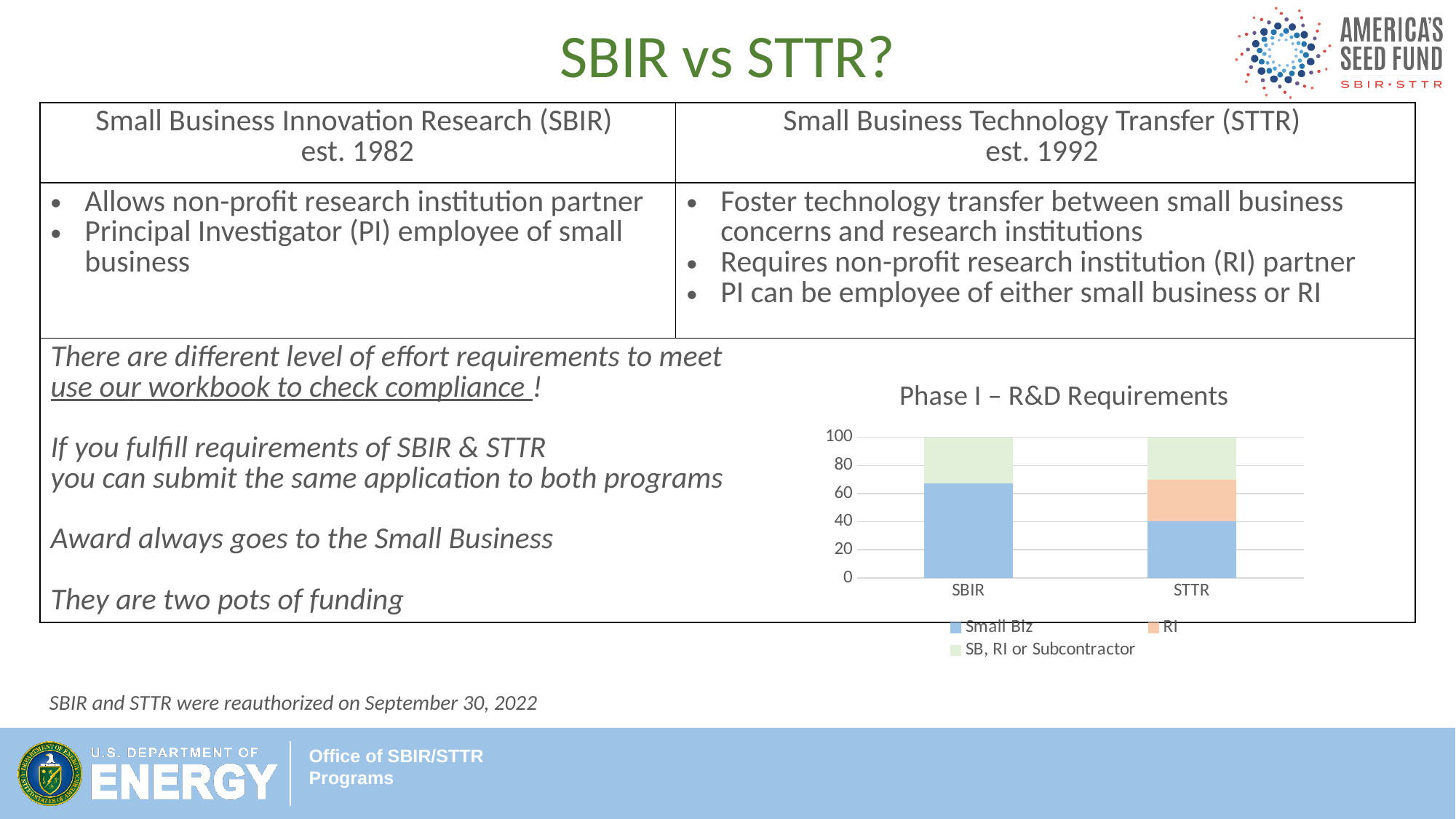
What is the Small Biz value for STTR in the Phase I – R&D Requirements chart? 40 What colour represents the Small Biz series in the chart? blue Is the Small Biz value for SBIR greater or less than 80? less What is the total of the stacked bar for STTR in the Phase I – R&D Requirements chart? 100 Which category has the larger Small Biz value, SBIR or STTR? SBIR How many categories are shown on the x axis of the Phase I – R&D Requirements chart? 2 What kind of chart is shown on the slide? bar chart What is the title of the chart on the slide? Phase I – R&D Requirements How many series does the legend of the Phase I – R&D Requirements chart list? 3 Is the Small Biz value for SBIR greater or less than 60? greater Is the top of the RI segment for STTR greater or less than 60? greater Which category has the larger Small Biz segment in the Phase I – R&D Requirements chart? SBIR